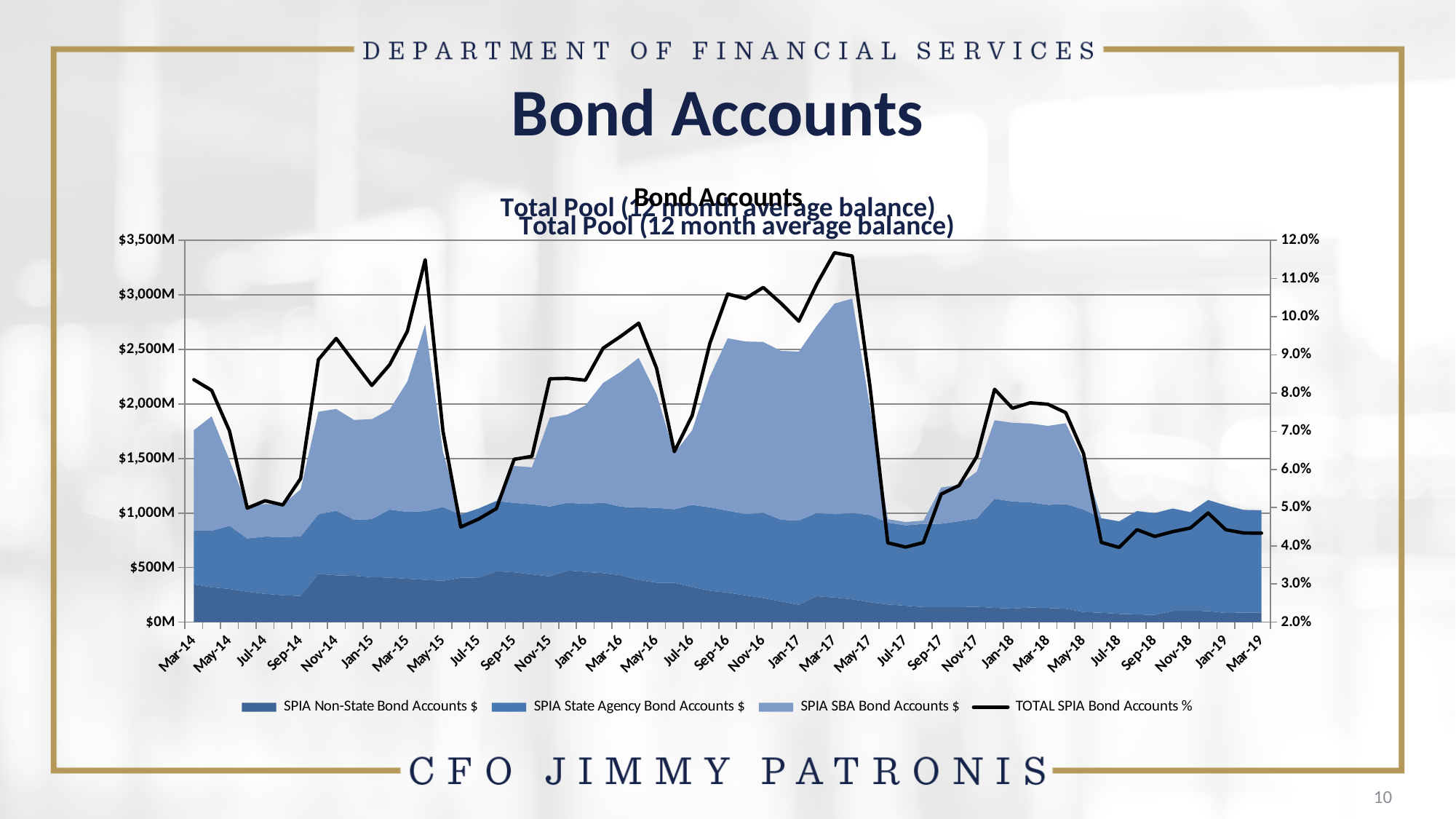
What kind of chart is shown on the slide? Stacked area chart with a line How many series does the legend list? 4 What is the highest value shown on the right-hand axis? 12.0% Is the TOTAL SPIA Bond Accounts % value at Mar-17 greater or less than 11.0%? greater Is the TOTAL SPIA Bond Accounts % value at Mar-19 greater or less than 5.0%? less Which is larger, the total stacked balance at Mar-17 or at Mar-19? Mar-17 Does the TOTAL SPIA Bond Accounts % line rise or fall between Mar-17 and Jul-17? fall Is the total stacked balance at Mar-14 greater or less than $1,500M? greater Which is larger, the TOTAL SPIA Bond Accounts % at Mar-14 or at Mar-19? Mar-14 Which series is drawn as a black line? TOTAL SPIA Bond Accounts %